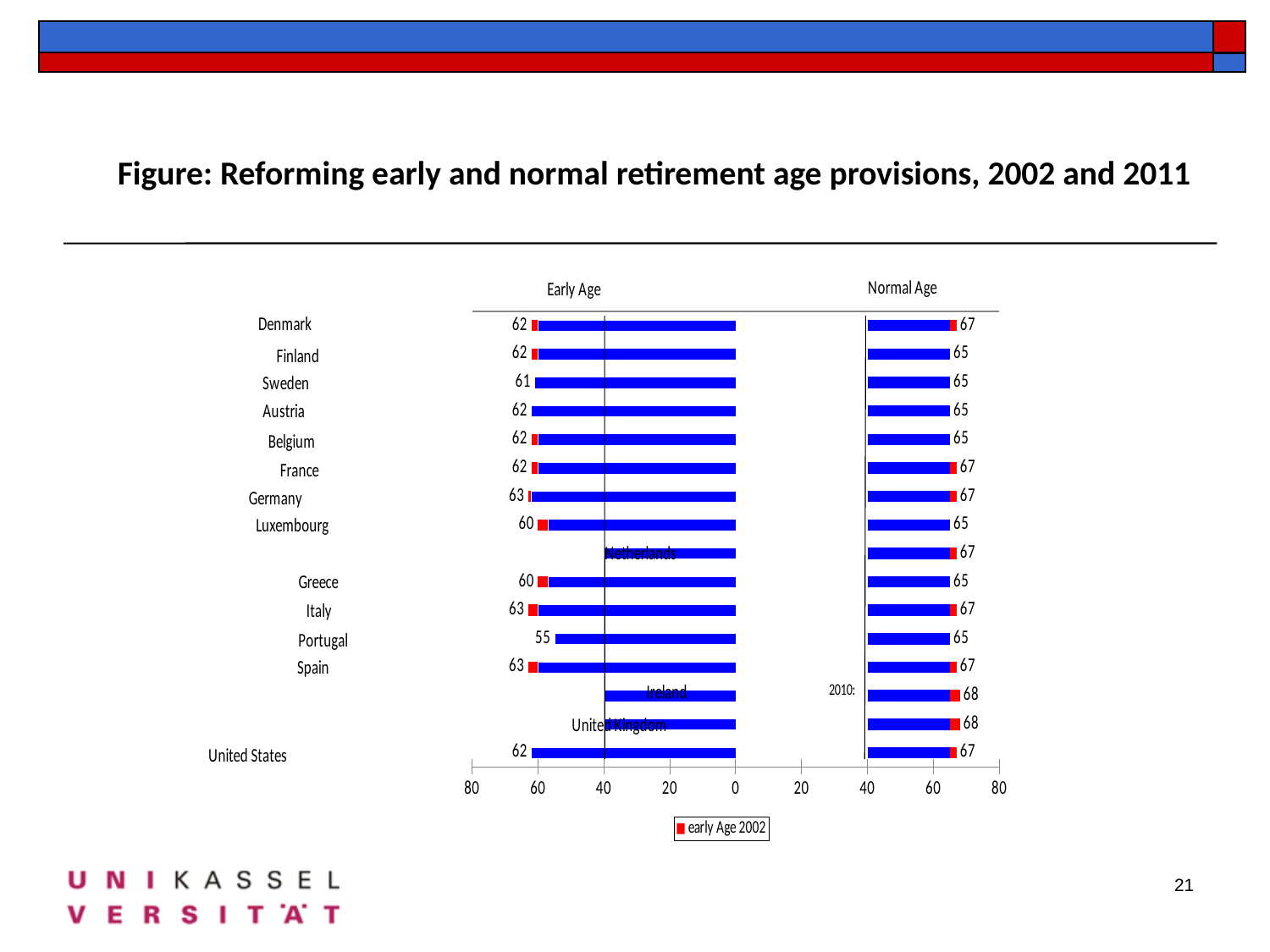
What is the early retirement age shown for Germany? 63 Which country has the lowest early retirement age in the chart? Portugal What is the difference between the normal and early retirement age for Denmark? 5 What is the normal retirement age shown for Ireland? 68 What entry does the legend below the chart show? early Age 2002 What kind of chart is shown on the slide? Bar chart Which has the higher early retirement age, Portugal or Luxembourg? Luxembourg What is the title of the figure on the slide? Figure: Reforming early and normal retirement age provisions, 2002 and 2011 What is the normal retirement age shown for Luxembourg? 65 What is the early retirement age shown for Portugal? 55 How many countries are listed in the chart? 16